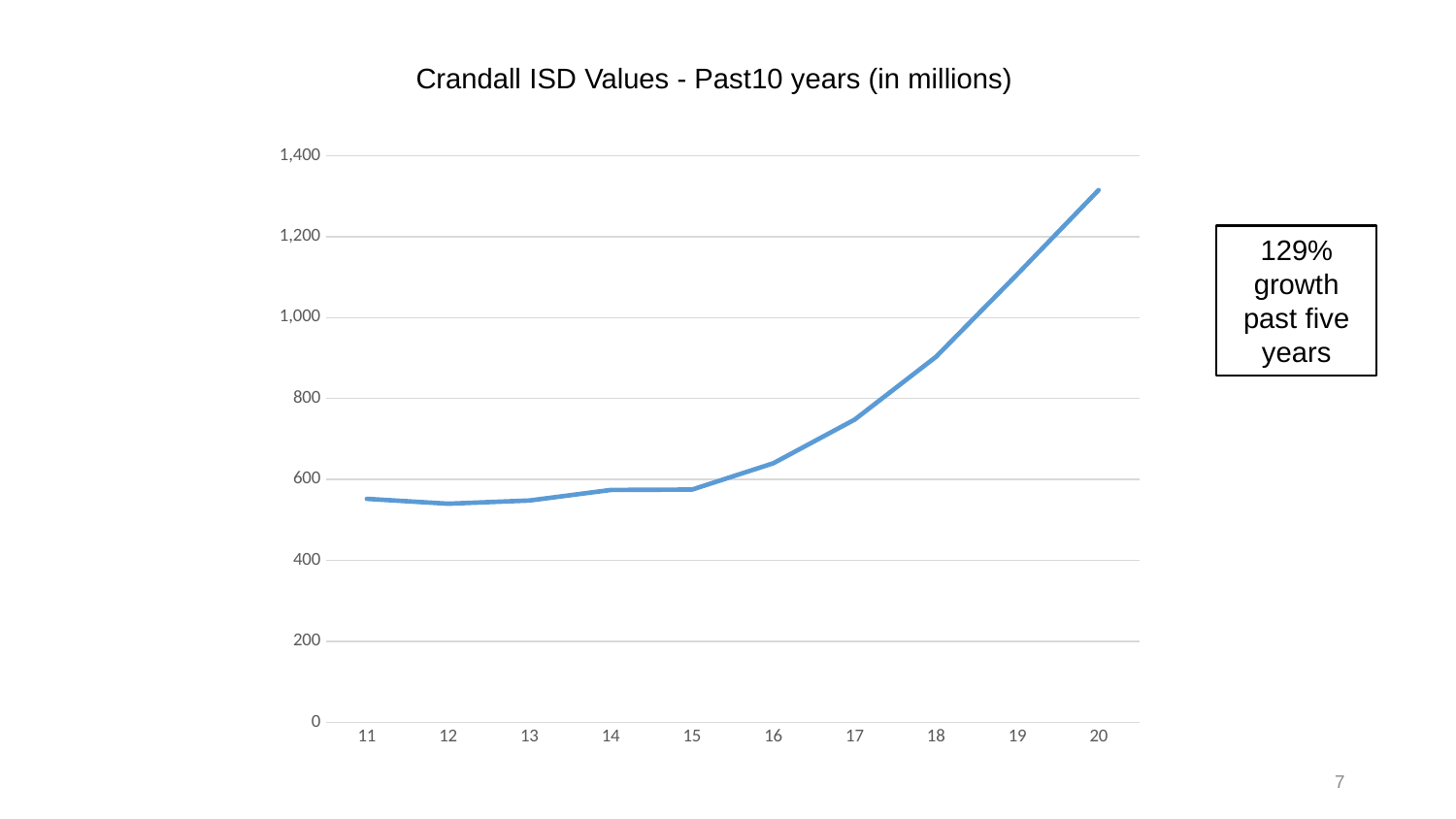
What kind of chart is shown on the slide? line chart Do the values generally rise or fall from year 15 to year 20? rise What is the title of the chart? Crandall ISD Values - Past10 years (in millions) Which year has the highest value? 20 What growth figure is stated in the text box beside the chart? 129% growth past five years Is the value for year 20 greater or less than 1,200? greater Is the value for year 19 greater or less than 1,000? greater Is the value for year 17 greater or less than 800? less How many years are plotted along the x axis? 10 Which is larger, the value for year 16 or the value for year 18? 18